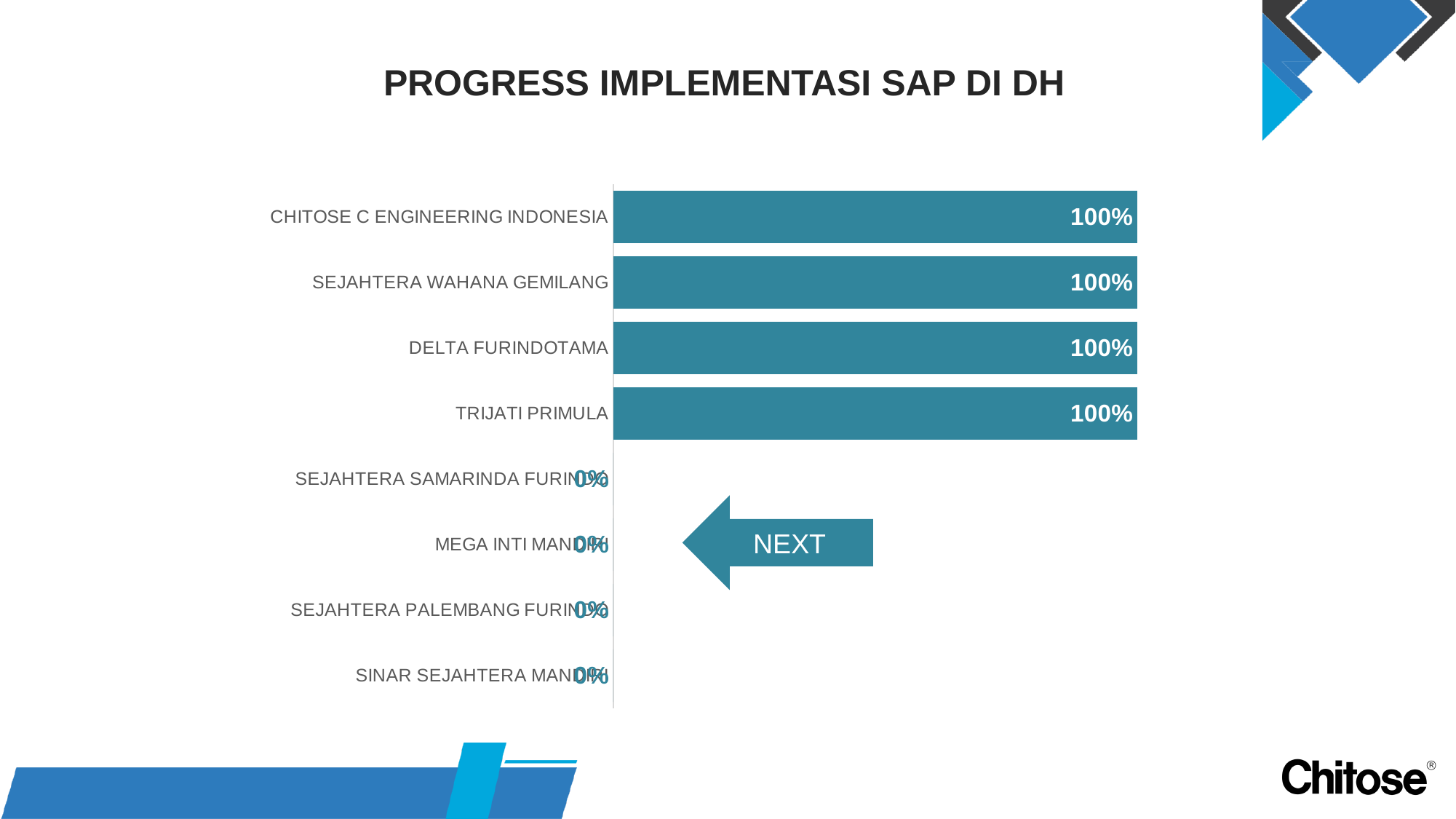
What is the value for SEJAHTERA WAHANA GEMILANG? 100% What colour are the bars in the chart? Teal blue What is the value for TRIJATI PRIMULA? 100% What is the value for CHITOSE C ENGINEERING INDONESIA? 100% What is the difference between the values for CHITOSE C ENGINEERING INDONESIA and TRIJATI PRIMULA? 0% How many categories in the chart have a value of 100%? 4 What type of chart is shown on the slide? Bar chart Is the value for DELTA FURINDOTAMA larger than, smaller than, or equal to the value for SEJAHTERA WAHANA GEMILANG? Equal How many categories are plotted in the chart? 8 How many categories in the chart have a value of 0%? 4 What is the title of the chart? PROGRESS IMPLEMENTASI SAP DI DH What is the value for DELTA FURINDOTAMA? 100%